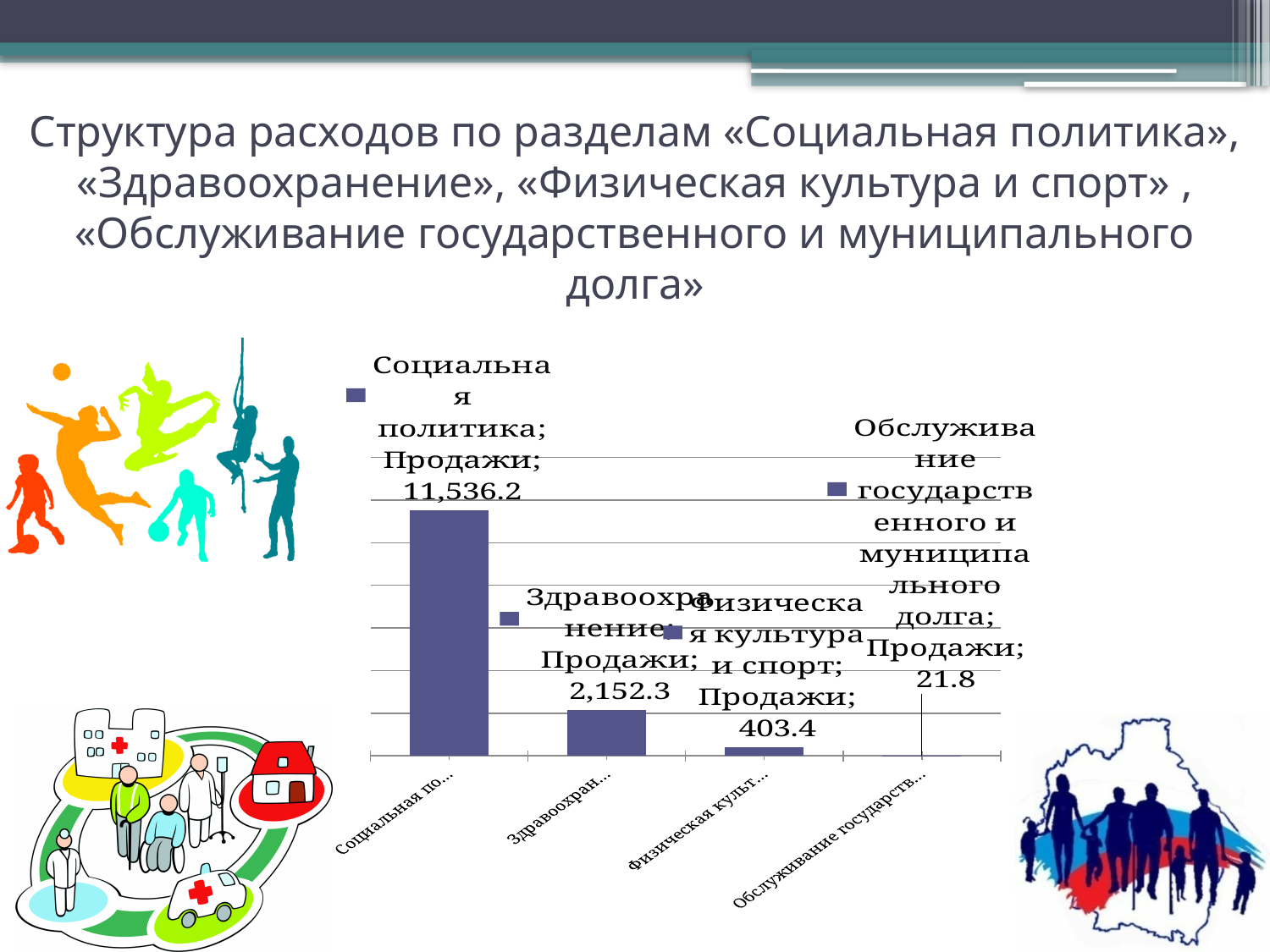
Which is larger, the value for Здравоохранение or the value for Физическая культура и спорт? Здравоохранение What is the value for Социальная политика? 11,536.2 How many categories are shown in the chart? 4 What is the difference between the values for Социальная политика and Здравоохранение? 9,383.9 What is the value for Обслуживание государственного и муниципального долга? 21.8 Which category has the highest value? Социальная политика What is the value for Здравоохранение? 2,152.3 Do the values rise or fall from left to right along the x axis? fall Which category has the lowest value? Обслуживание государственного и муниципального долга What kind of chart is shown on the slide? bar chart What is the difference between the values for Физическая культура и спорт and Обслуживание государственного и муниципального долга? 381.6 What is the value for Физическая культура и спорт? 403.4